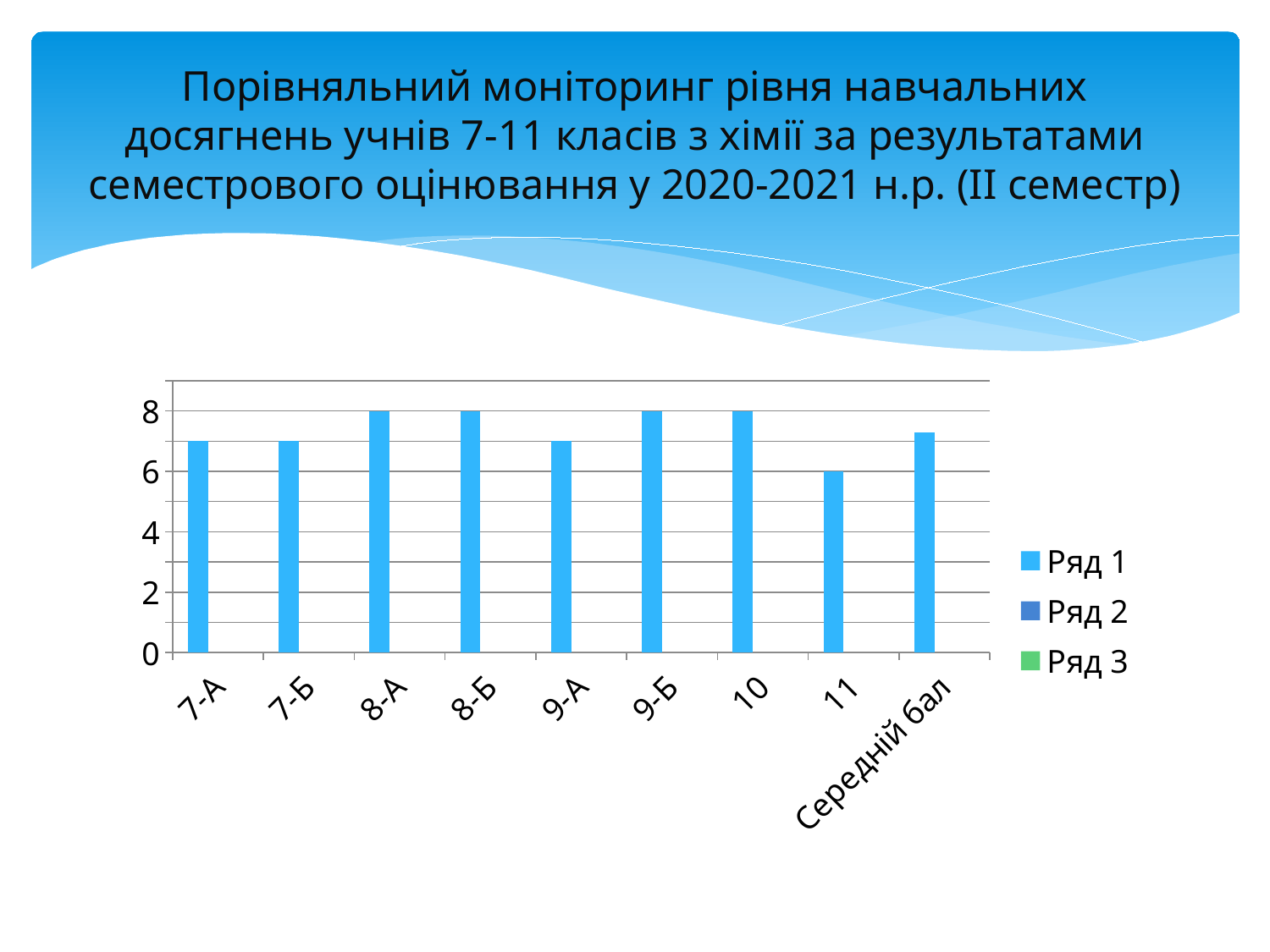
Which category has the lowest value? 11 What is the name of the first series in the legend? Ряд 1 Which is larger, the value for 8-Б or the value for 11? 8-Б What is the difference between the values for 8-А and 11? 2 What is the value for 11? 6 Is the value for Середній бал greater or less than 8? less What type of chart is shown on the slide? bar chart How many categories are shown on the x axis of the chart? 9 What is the value for 8-А? 8 What is the value for 10? 8 Is the value for 7-А greater or less than 6? greater How many series does the chart legend list? 3